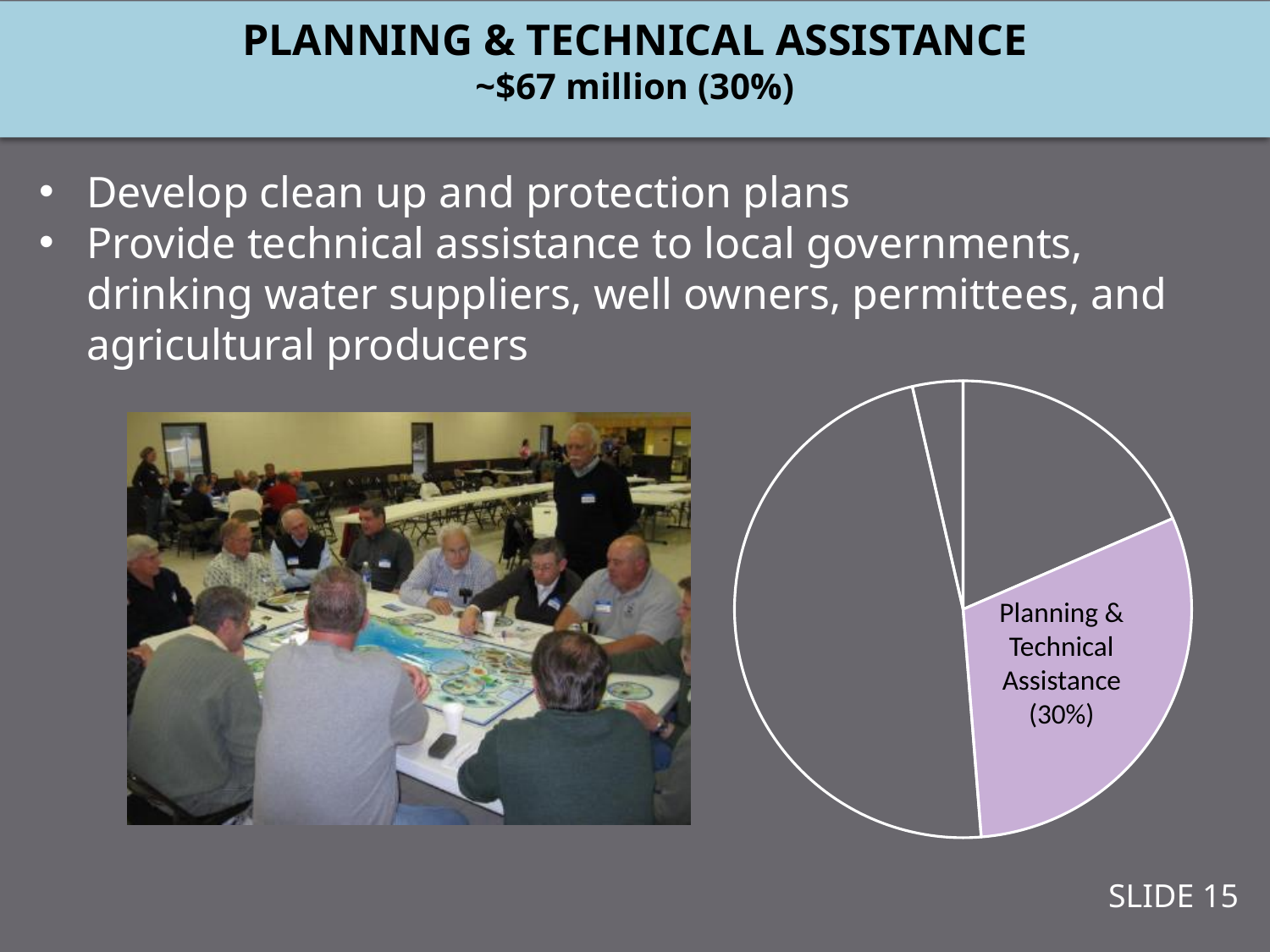
How many slices does the pie chart have? 4 Is the Planning & Technical Assistance slice the largest slice in the pie chart? No Is the share for Planning & Technical Assistance greater or less than 50%? less What share of the pie does the Planning & Technical Assistance slice represent? 30% What kind of chart is shown on the slide? Pie chart What colour is the Planning & Technical Assistance slice in the pie chart? Light purple Which slice of the pie chart is labeled? Planning & Technical Assistance